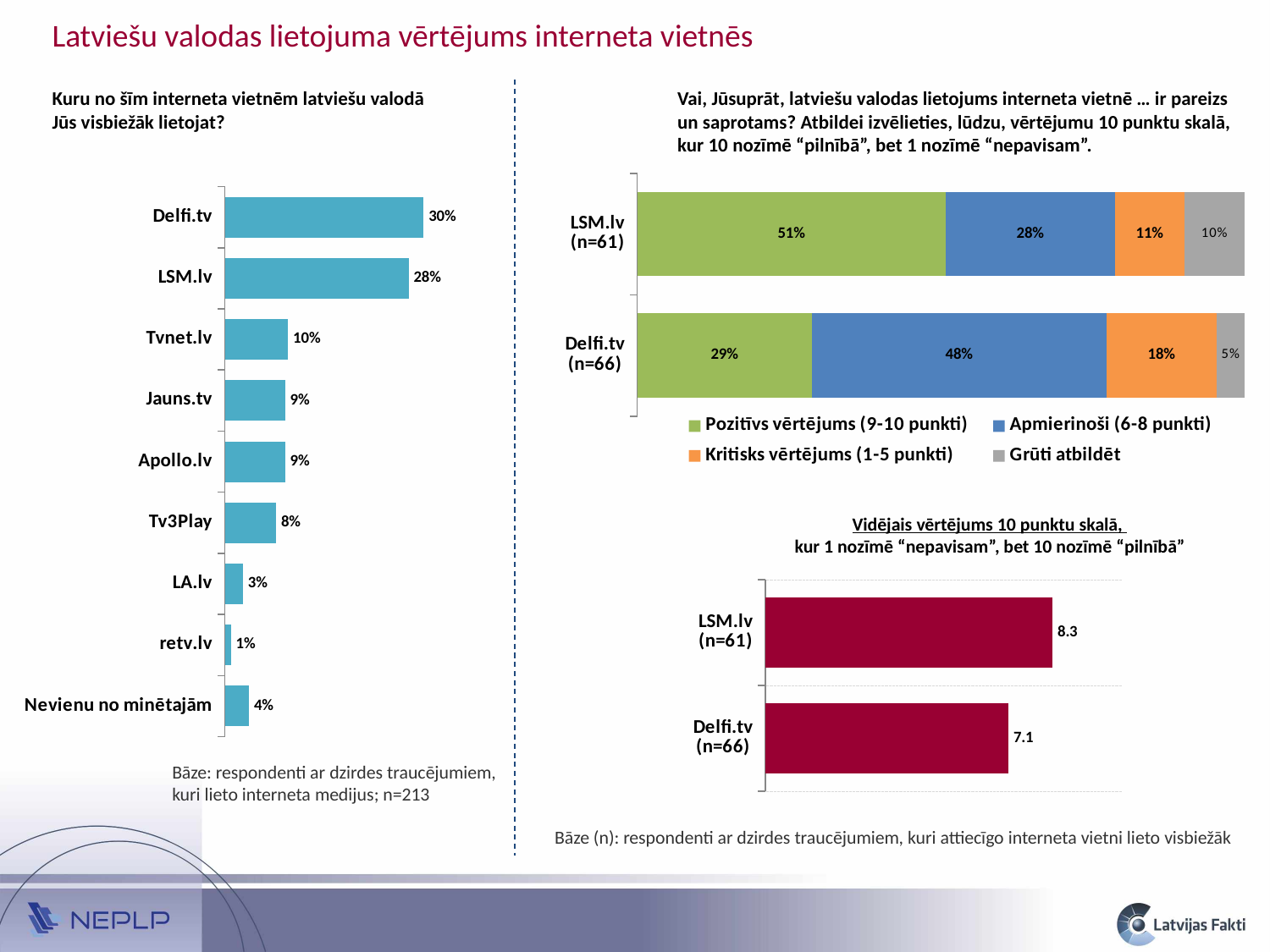
In the left-hand bar chart, which named website has the lowest value? retv.lv In the top-right stacked bar chart, what share of LSM.lv (n=61) respondents gave a positive rating (9-10 points)? 51% In the left-hand bar chart, what percentage is shown for Delfi.tv? 30% In the bottom-right chart titled 'Vidējais vērtējums 10 punktu skalā', what is the average rating for Delfi.tv (n=66)? 7.1 In the top-right stacked bar chart, what is the total of the Delfi.tv (n=66) bar? 100% In the left-hand bar chart, how many categories are shown? 9 In the left-hand bar chart, which is larger: the value for Tvnet.lv or the value for Tv3Play? Tvnet.lv In the bottom-right chart titled 'Vidējais vērtējums 10 punktu skalā', what is the difference between the average ratings for LSM.lv and Delfi.tv? 1.2 In the left-hand bar chart, which website has the highest value? Delfi.tv In the top-right stacked bar chart, what share of Delfi.tv (n=66) respondents gave a critical rating (1-5 points)? 18% In the top-right stacked bar chart, how many series does the legend list? 4 In the left-hand bar chart, what is the difference between the values for Delfi.tv and LSM.lv? 2 percentage points